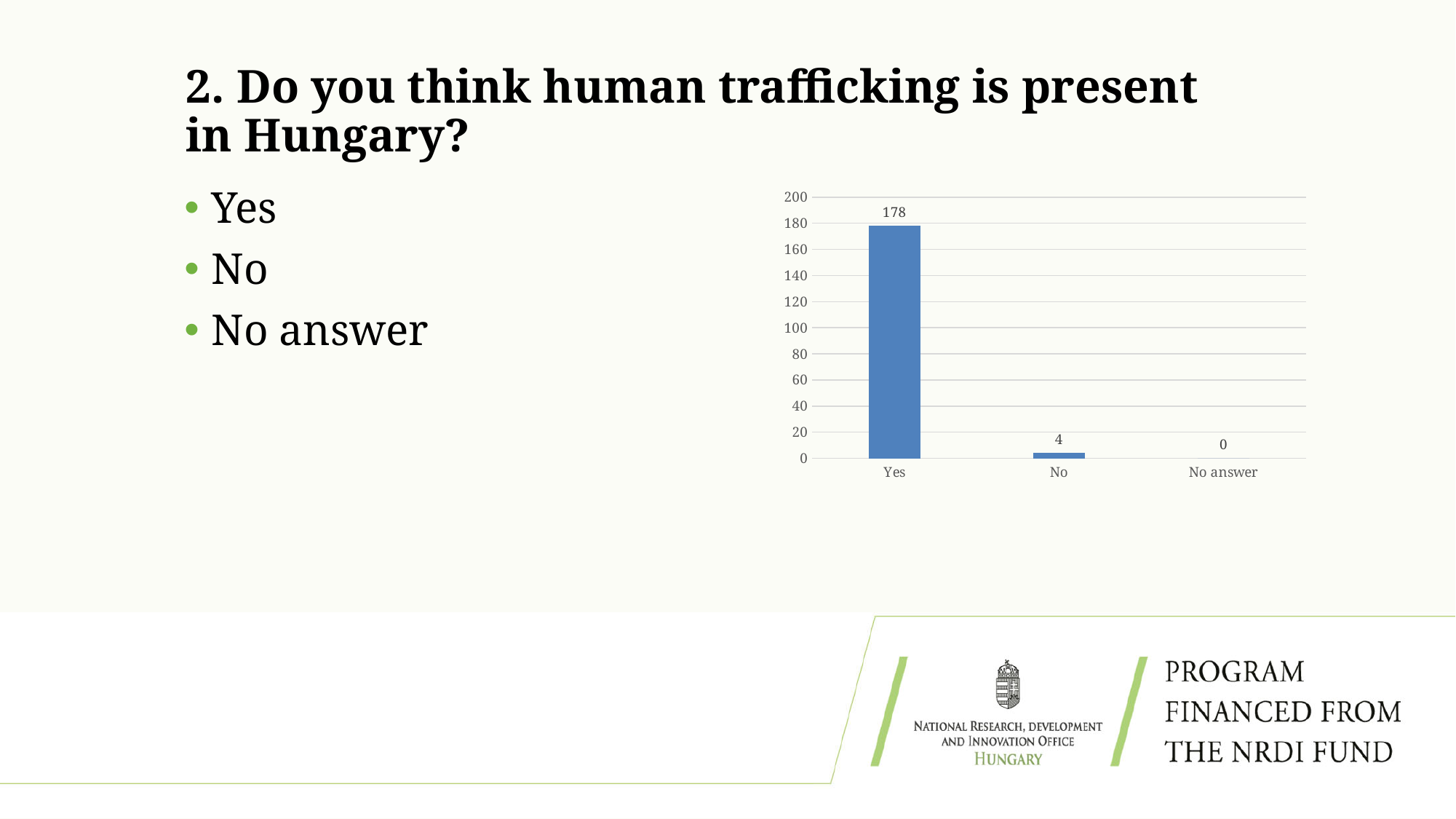
What is the value for No? 4 Is the value for Yes greater or less than 160? greater Do the values rise or fall from left to right along the x axis? fall How many categories are shown on the x axis? 3 What is the difference between the values for Yes and No? 174 What is the value for No answer? 0 Which is larger, the value for No or the value for No answer? No Which category has the highest value? Yes What kind of chart is shown on the slide? bar chart What is the highest value shown on the y axis? 200 What is the value for Yes? 178 Which category has the lowest value? No answer